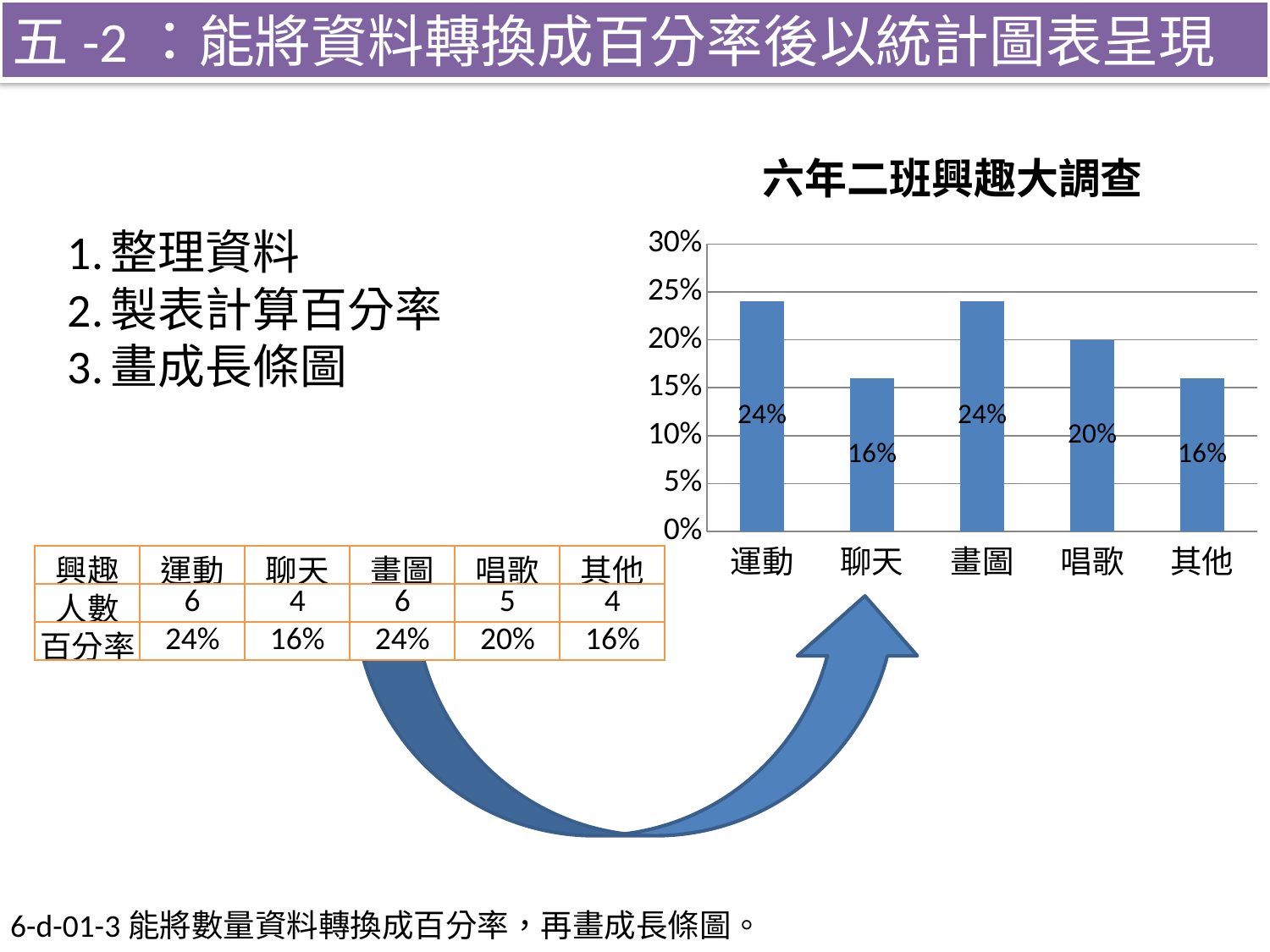
What is the difference between the values for 運動 and 聊天? 8% Which has a larger value, 畫圖 or 其他? 畫圖 What is the difference between the values for 唱歌 and 其他? 4% What kind of chart is shown on the slide? Bar chart What is the value for 聊天 in the chart? 16% What is the value for 其他 in the chart? 16% What is the value for 唱歌 in the chart? 20% What is the title of the chart? 六年二班興趣大調查 How many categories are shown in the chart? 5 What is the value for 運動 in the chart? 24% What is the value for 畫圖 in the chart? 24% Which has a larger value, 唱歌 or 聊天? 唱歌